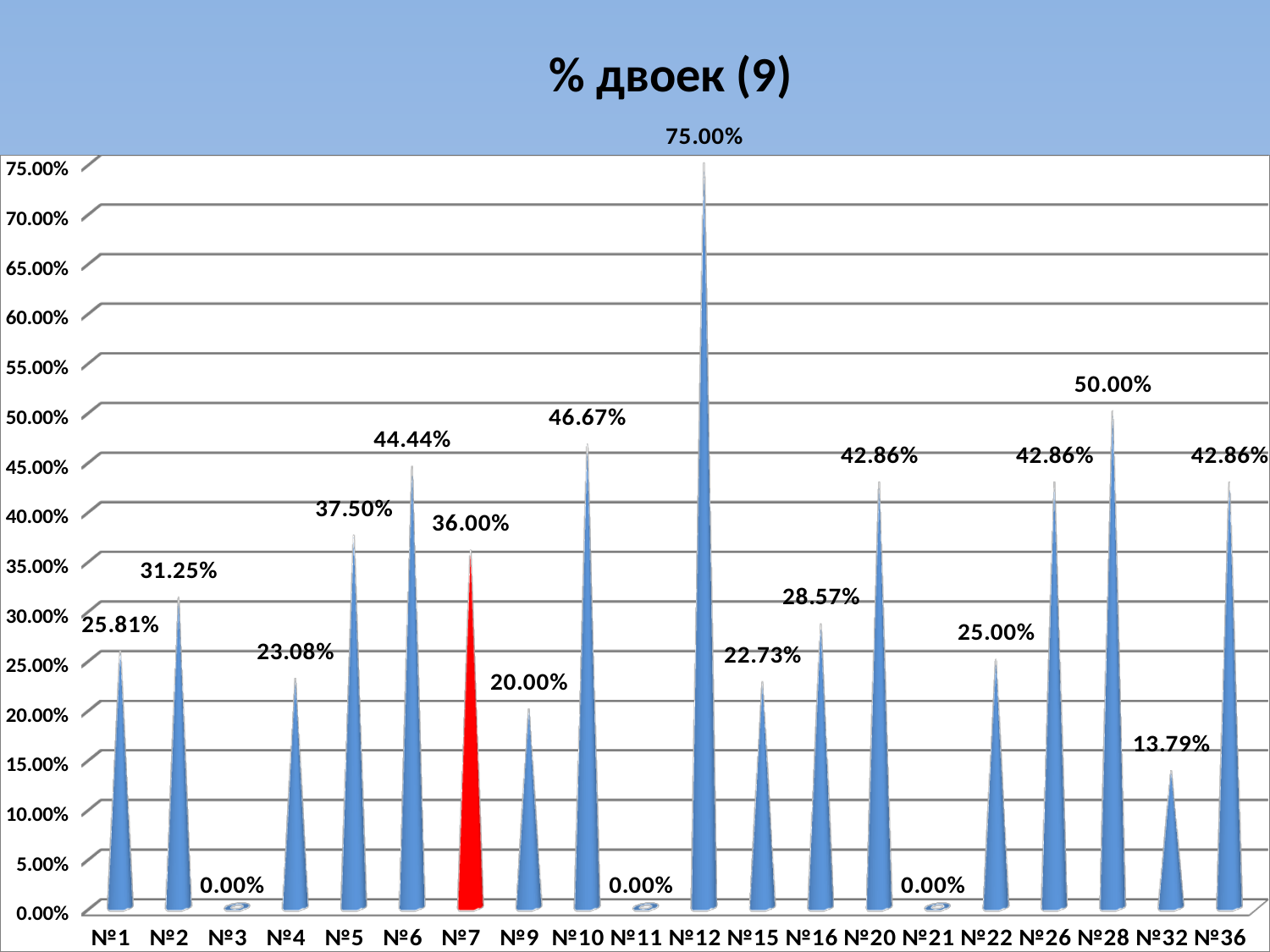
Which category's bar is coloured red? №7 What is the value for №32? 13.79% How many categories are shown on the x axis? 20 Which is larger, the value for №5 or the value for №16? №5 Which category has the highest value? №12 What is the value for №7? 36.00% What is the value for №12? 75.00% What kind of chart is this? Bar chart What is the difference between the values for №12 and №10? 28.33 percentage points What is the title of the chart? % двоек (9) What is the difference between the values for №28 and №6? 5.56 percentage points How many categories have a value of 0.00%? 3